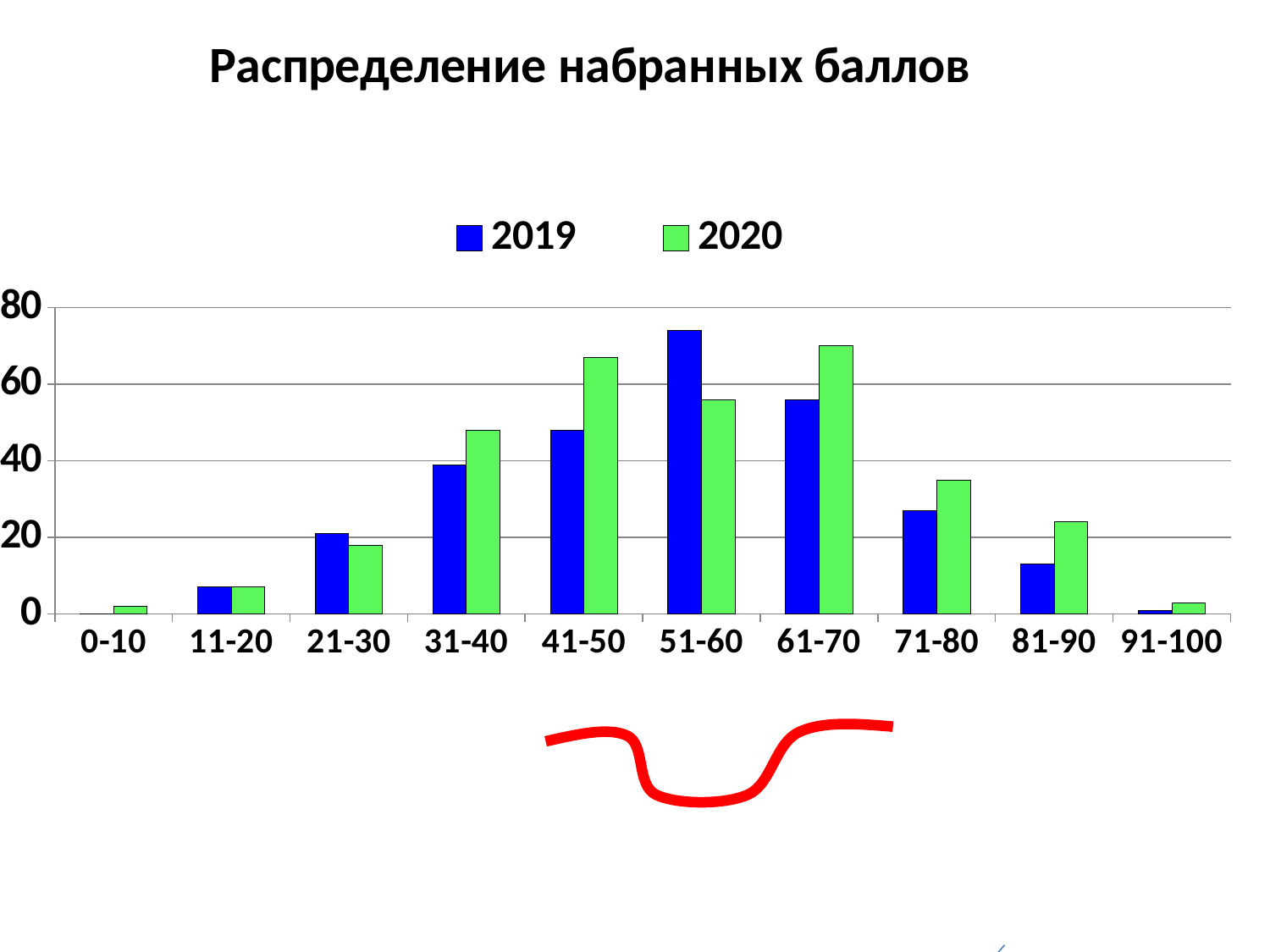
How many series does the legend list? 2 What is the title of the chart? Распределение набранных баллов For the 51-60 range, which year has the larger value, 2019 or 2020? 2019 Which score range has the highest value for 2019? 51-60 For the 61-70 range, which year has the larger value, 2019 or 2020? 2020 Is the value for 2019 in the 51-60 range greater or less than 60? greater Which score range has the lowest value for 2019? 0-10 What kind of chart is shown on the slide? bar chart How many score ranges are shown on the x axis? 10 Is the value for 2020 in the 71-80 range greater or less than 40? less For the 41-50 range, which year has the larger value, 2019 or 2020? 2020 Is the value for 2019 in the 81-90 range greater or less than 20? less